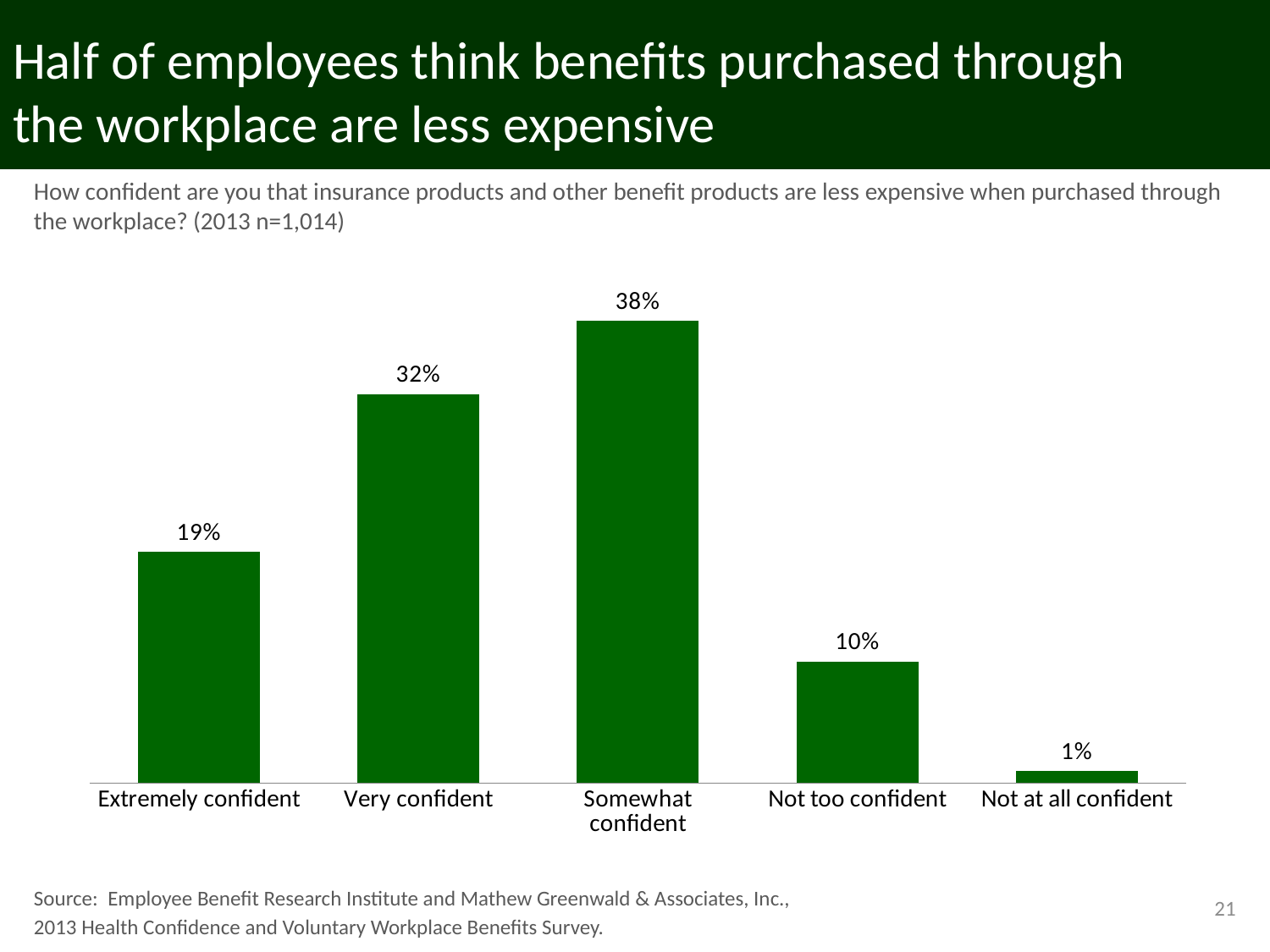
What is the difference in percentage points between Extremely confident and Not too confident? 9 What is the sample size (n) given for the 2013 survey question on the slide? 1,014 What is the value shown for Extremely confident? 19% What kind of chart is shown on the slide? Bar chart What is the value shown for Not too confident? 10% How many confidence categories are shown on the chart? 5 Which confidence level has the highest percentage? Somewhat confident What percentage of employees are Somewhat confident that benefits purchased through the workplace are less expensive? 38% What is the value shown for Not at all confident? 1% Which confidence level has the lowest percentage? Not at all confident What is the difference in percentage points between Somewhat confident and Very confident? 6 Which is larger, the value for Very confident or the value for Extremely confident? Very confident